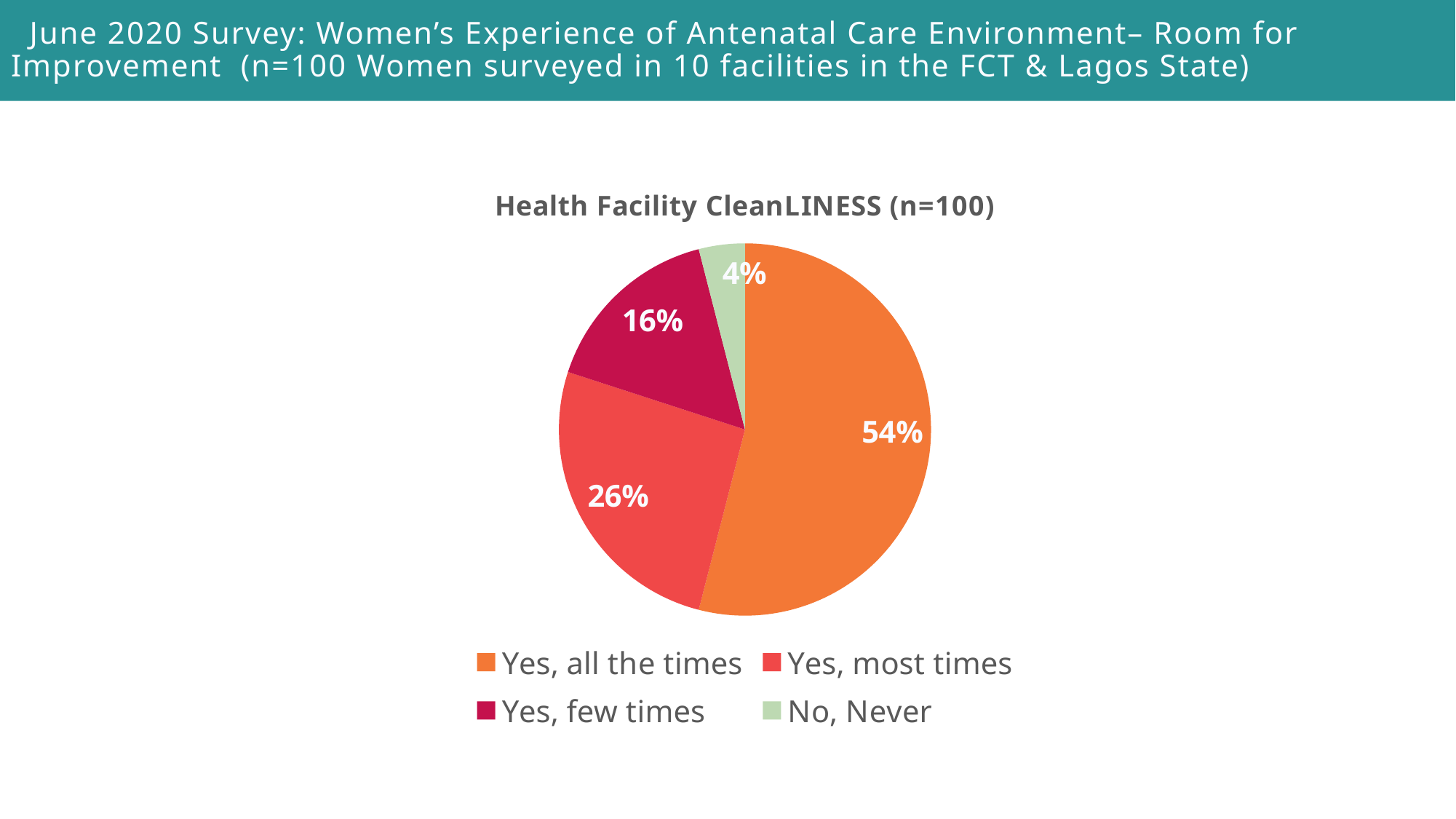
How many categories does the legend list? 4 What type of chart is shown on the slide? Pie chart What colour is the slice for "No, Never"? Light green Which response category has the largest share of the pie? Yes, all the times What percentage of women answered "No, Never"? 4% What percentage of women answered "Yes, all the times"? 54% What percentage of women answered "Yes, most times"? 26% Which response category has the smallest share of the pie? No, Never What percentage of women answered "Yes, few times"? 16% What is the title of the chart? Health Facility CleanLINESS (n=100) Which is larger: the share for "Yes, few times" or the share for "No, Never"? Yes, few times What is the difference in percentage points between "Yes, all the times" and "Yes, most times"? 28